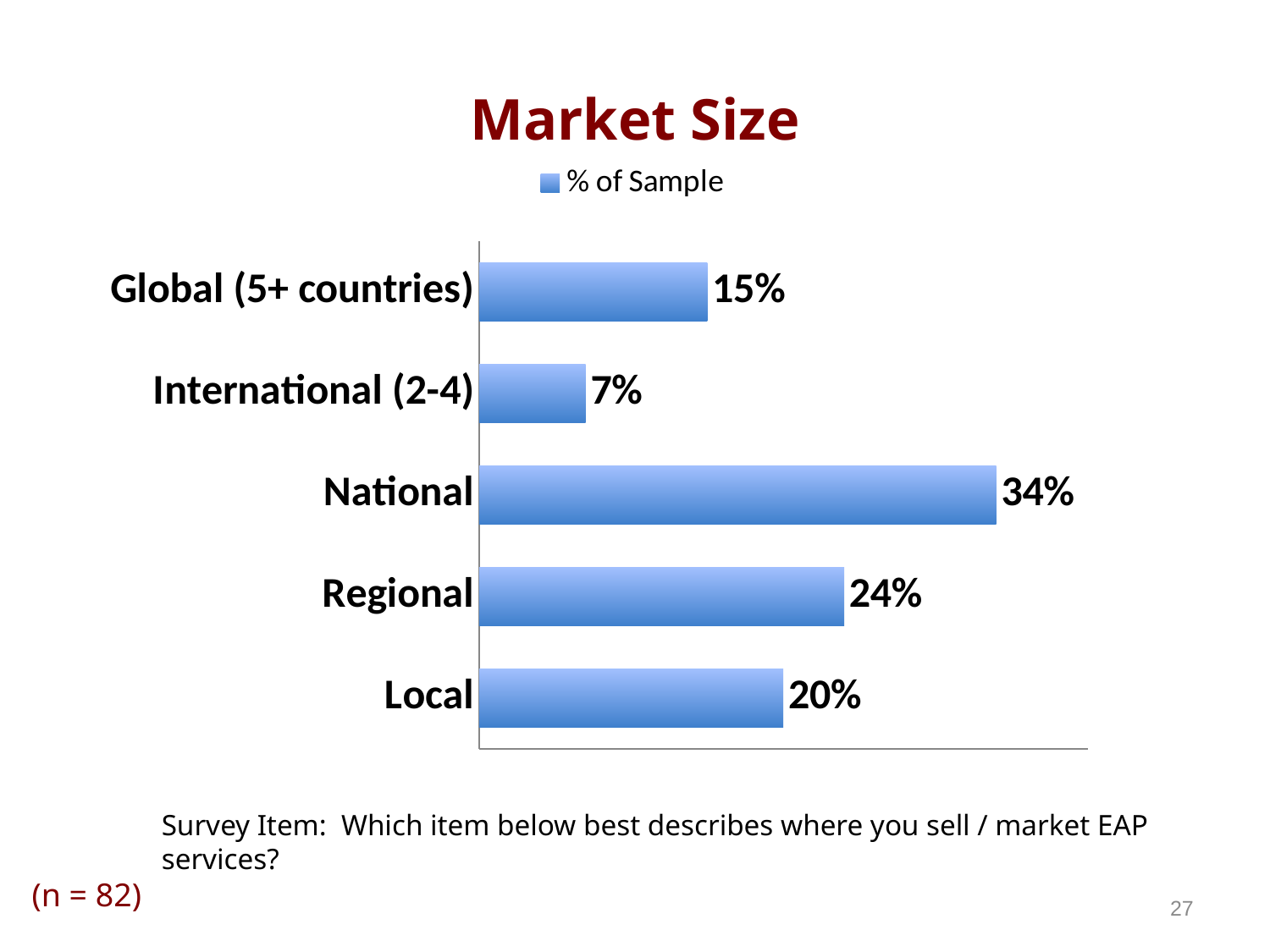
What is the difference between the values for Local and International (2-4)? 13% What series name does the legend show? % of Sample What kind of chart is shown on the slide? Bar chart Which is larger, the value for Regional or the value for Local? Regional What is the value for National? 34% What is the value for International (2-4)? 7% Which category has the highest value? National Which category has the lowest value? International (2-4) How many categories are shown in the chart? 5 What is the difference between the values for National and Regional? 10% What is the value for Local? 20% What is the value for Global (5+ countries)? 15%